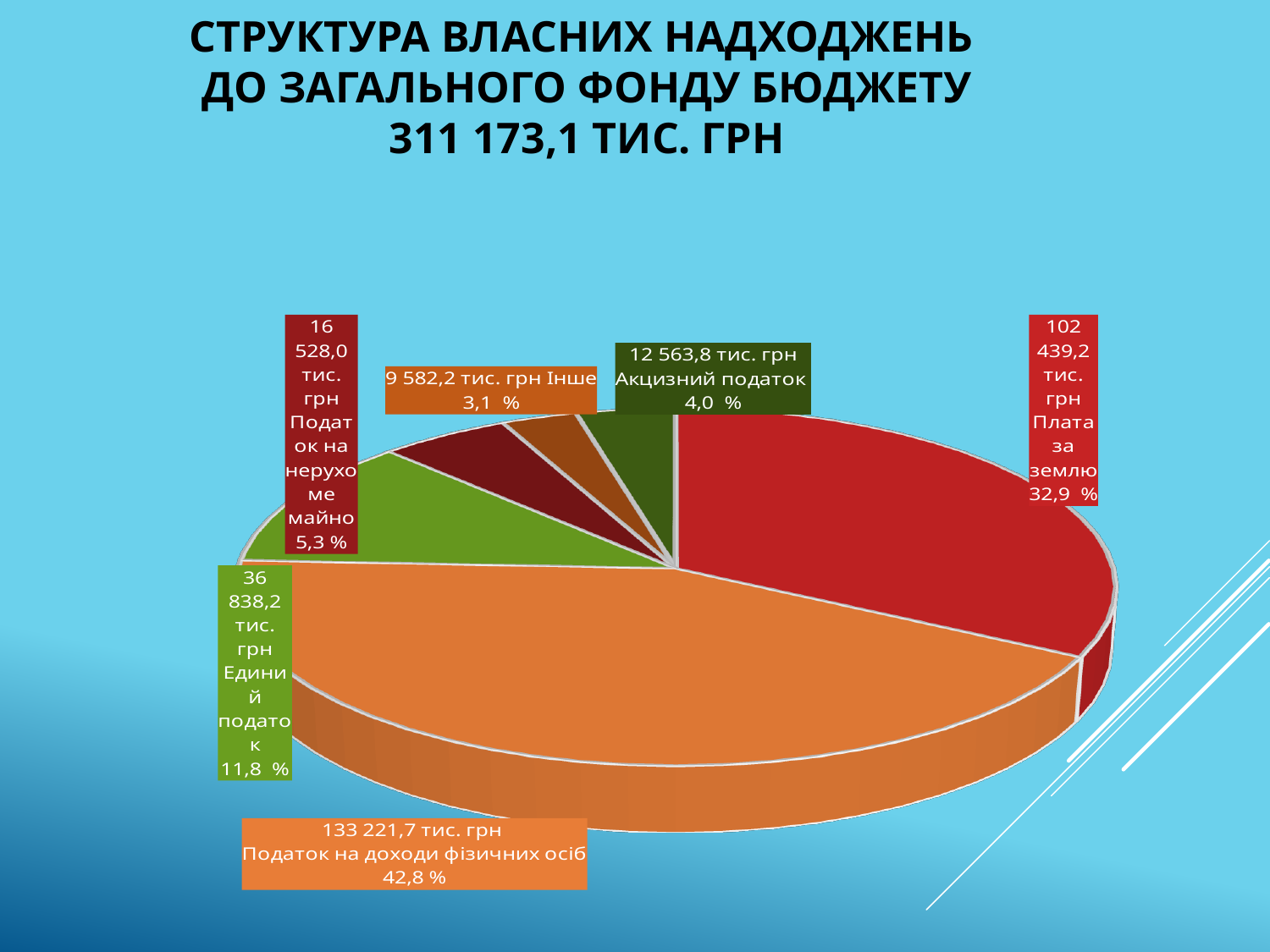
Which is larger, the value for Акцизний податок or the value for Інше? Акцизний податок What is the value for Единий податок? 36 838,2 тис. грн What is the value for Плата за землю? 102 439,2 тис. грн What kind of chart is shown on the slide? pie chart Which category has the smallest share of the pie? Інше What is the value for Податок на доходи фізичних осіб? 133 221,7 тис. грн How many slices does the pie chart have? 6 What is the value for Акцизний податок? 12 563,8 тис. грн What share of the pie does Плата за землю represent? 32,9 % Which category has the largest share of the pie? Податок на доходи фізичних осіб What is the difference in percentage share between Податок на доходи фізичних осіб and Плата за землю? 9,9 % What share of the pie does Податок на нерухоме майно represent? 5,3 %